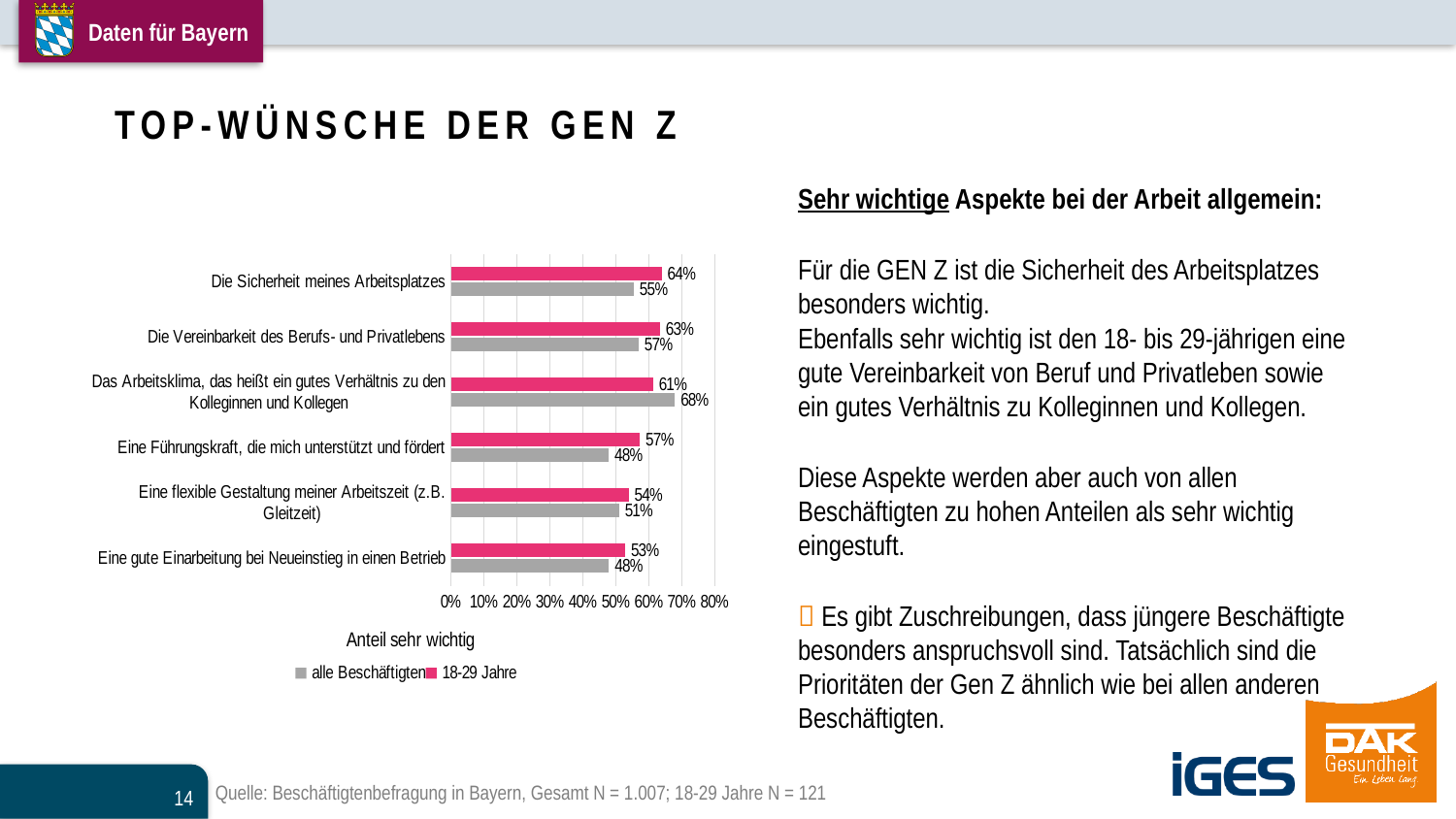
Which category has the highest value for the 18-29 Jahre series? Die Sicherheit meines Arbeitsplatzes For 'Das Arbeitsklima', which series has the larger value: alle Beschäftigten or 18-29 Jahre? alle Beschäftigten What is the value for 'alle Beschäftigten' for 'Eine Führungskraft, die mich unterstützt und fördert'? 48% What is the axis title shown below the chart? Anteil sehr wichtig What is the difference between the 18-29 Jahre and alle Beschäftigten values for 'Die Sicherheit meines Arbeitsplatzes'? 9 percentage points How many categories are shown in the chart? 6 Which category has the lowest value for the 18-29 Jahre series? Eine gute Einarbeitung bei Neueinstieg in einen Betrieb What percentage of 18-29 Jahre rate 'Die Sicherheit meines Arbeitsplatzes' as very important? 64% Which colour represents the 18-29 Jahre series in the chart? Pink/red What is the value for 'alle Beschäftigten' for 'Das Arbeitsklima, das heißt ein gutes Verhältnis zu den Kolleginnen und Kollegen'? 68% How many series does the legend list? 2 What type of chart is shown on the slide? Bar chart